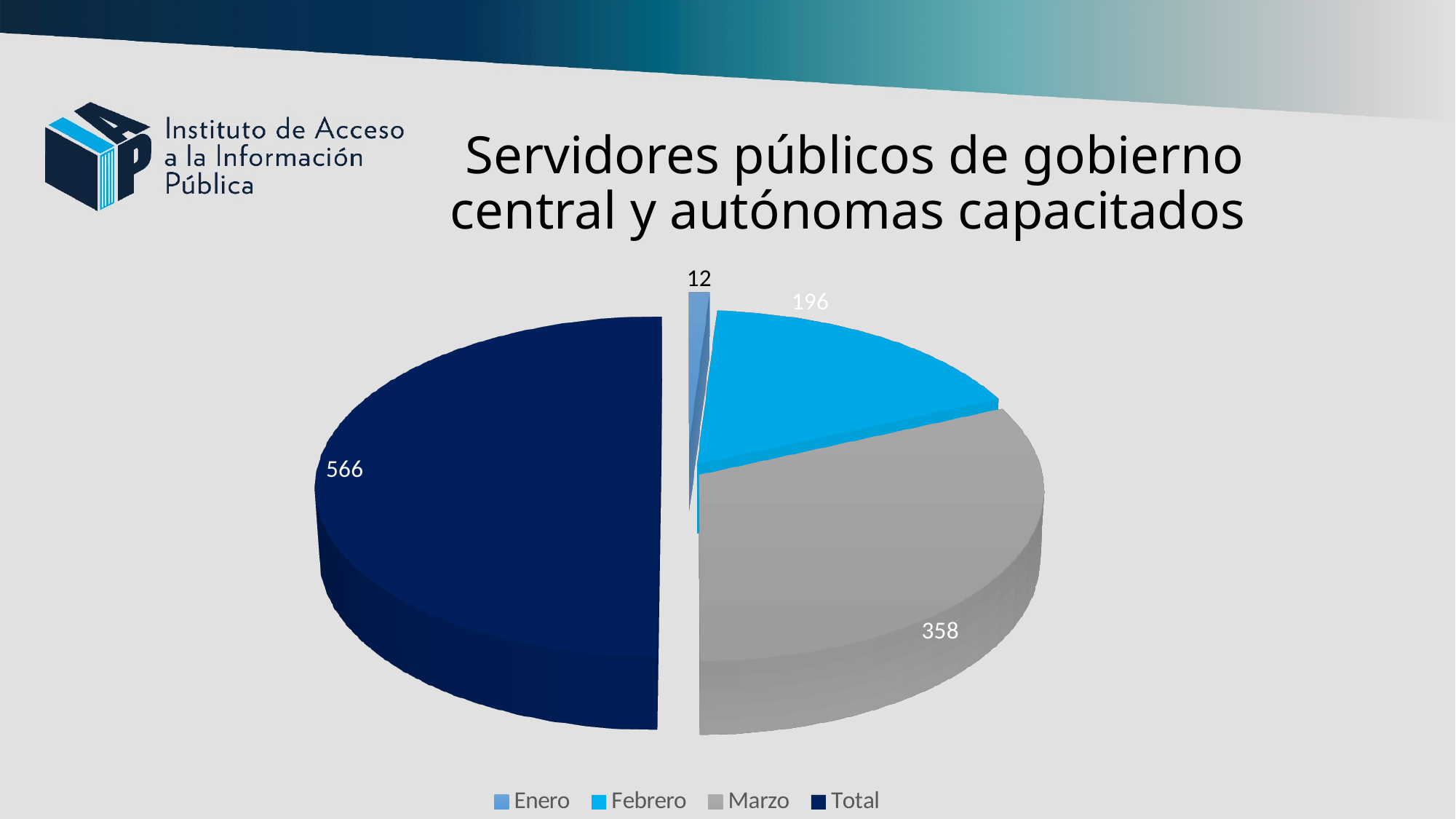
Which slice has the smallest value? Enero What is the value for Febrero? 196 What is the difference between the values for Marzo and Febrero? 162 Which slice has the largest value? Total What is the value for the Total slice? 566 What is the title of the chart? Servidores públicos de gobierno central y autónomas capacitados How many entries does the legend list? 4 What kind of chart is shown on the slide? pie chart What is the value for Enero? 12 Which is larger, the value for Febrero or the value for Marzo? Marzo How many slices does the pie chart have? 4 What is the value for Marzo? 358